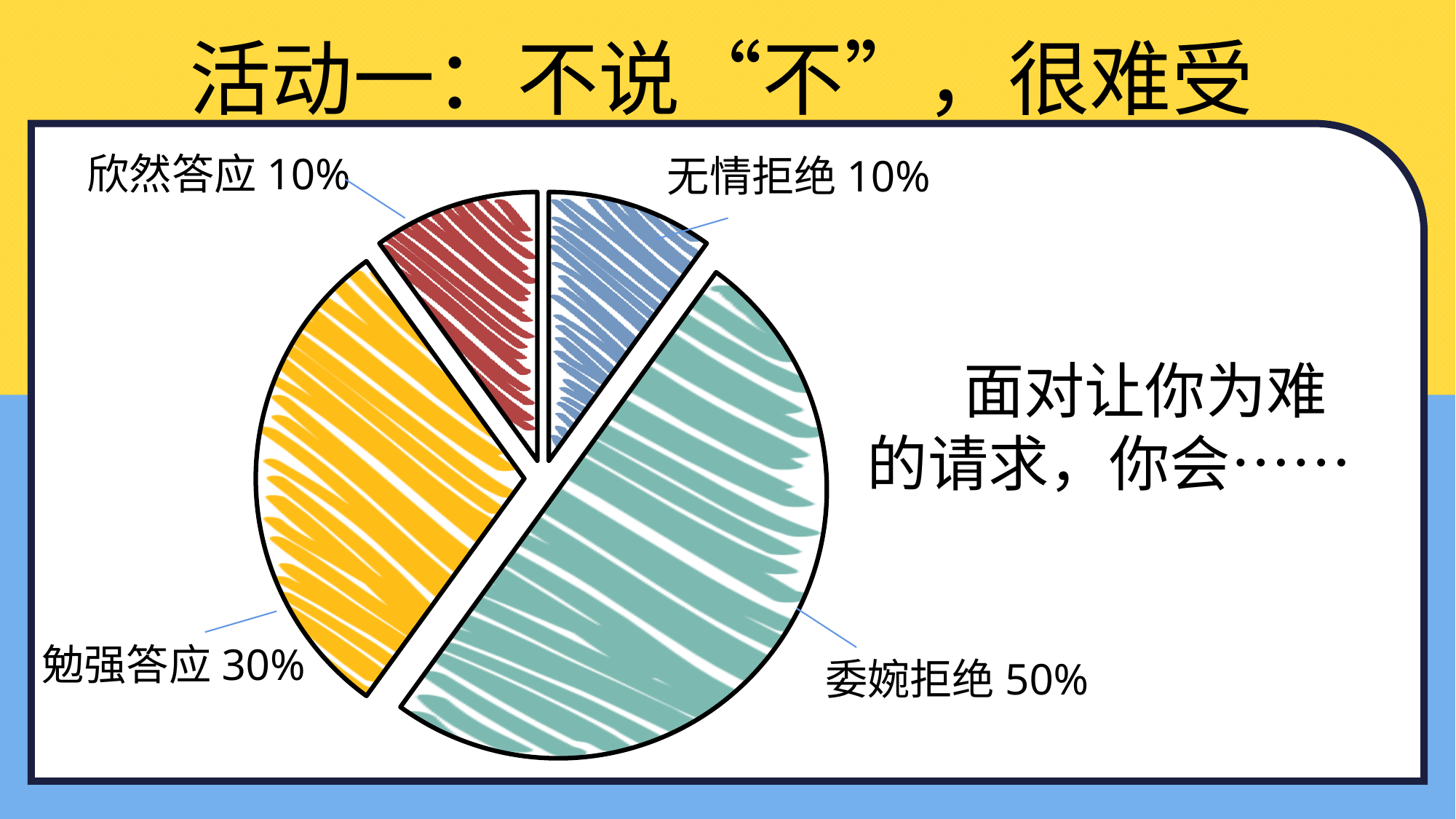
Which category has the largest slice of the pie? 委婉拒绝 What share of the pie does 无情拒绝 have? 10% Which is larger, the share of 勉强答应 or the share of 欣然答应? 勉强答应 What kind of chart is shown on the slide? pie chart What colour is the 委婉拒绝 slice? teal green What share of the pie does 欣然答应 have? 10% What question does the text next to the pie chart pose? 面对让你为难的请求，你会…… How many slices does the pie chart have? 4 What share of the pie does 勉强答应 have? 30% What is the combined share of 欣然答应 and 勉强答应? 40% What is the difference between the shares of 委婉拒绝 and 勉强答应? 20%